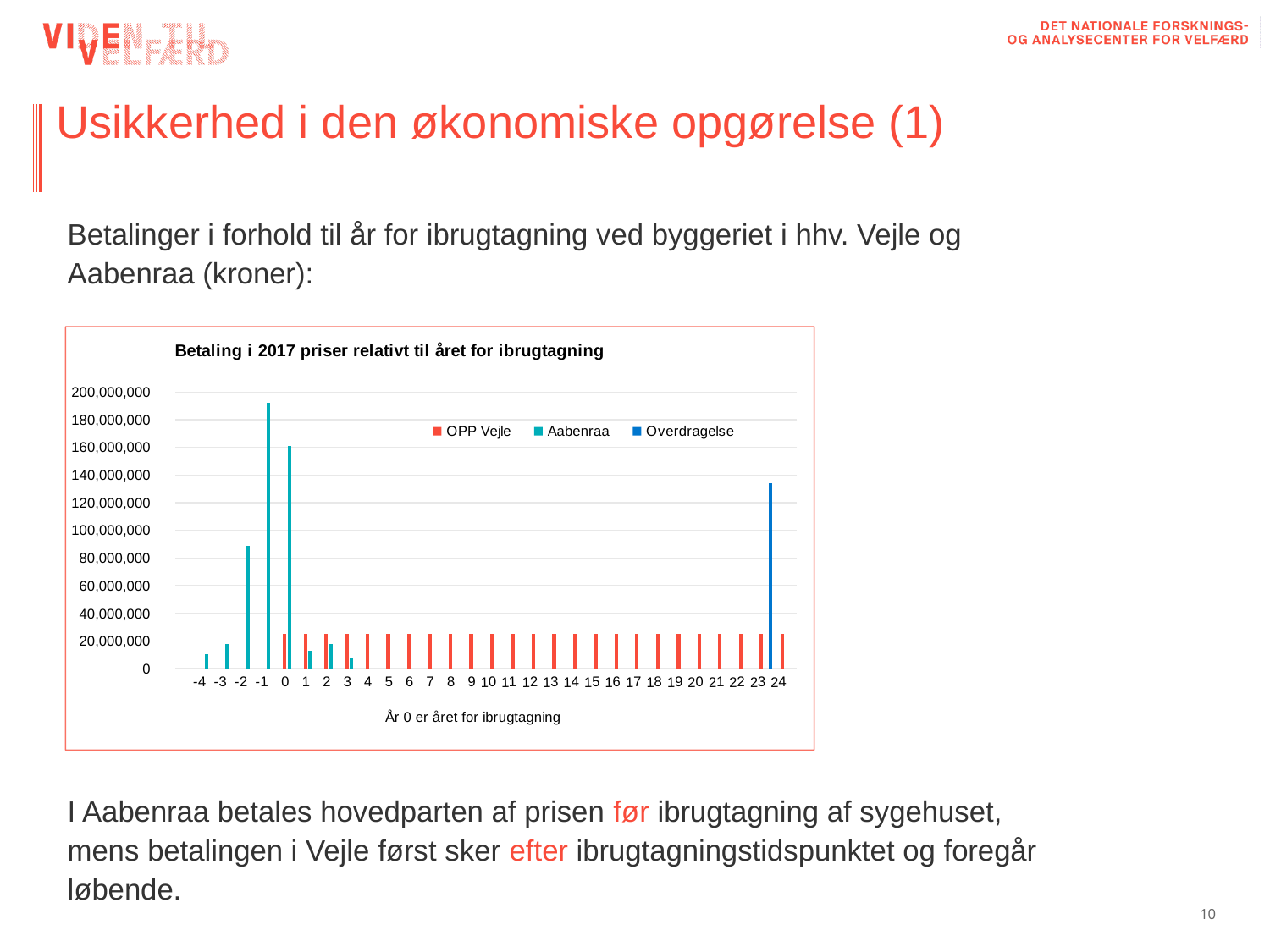
Is the Aabenraa value for year -1 greater or less than 180,000,000? greater Is the Aabenraa value for year 0 greater or less than 140,000,000? greater What is the title of the chart? Betaling i 2017 priser relativt til året for ibrugtagning What kind of chart is shown on the slide? Bar chart Is the OPP Vejle value for year 10 greater or less than 40,000,000? less In which year does the Aabenraa series reach its highest value? -1 What are the three series named in the chart legend? OPP Vejle, Aabenraa, Overdragelse How many series does the chart legend list? 3 Which is larger: the Aabenraa value for year -1 or the Aabenraa value for year 0? Year -1 How many year categories are shown on the x axis? 29